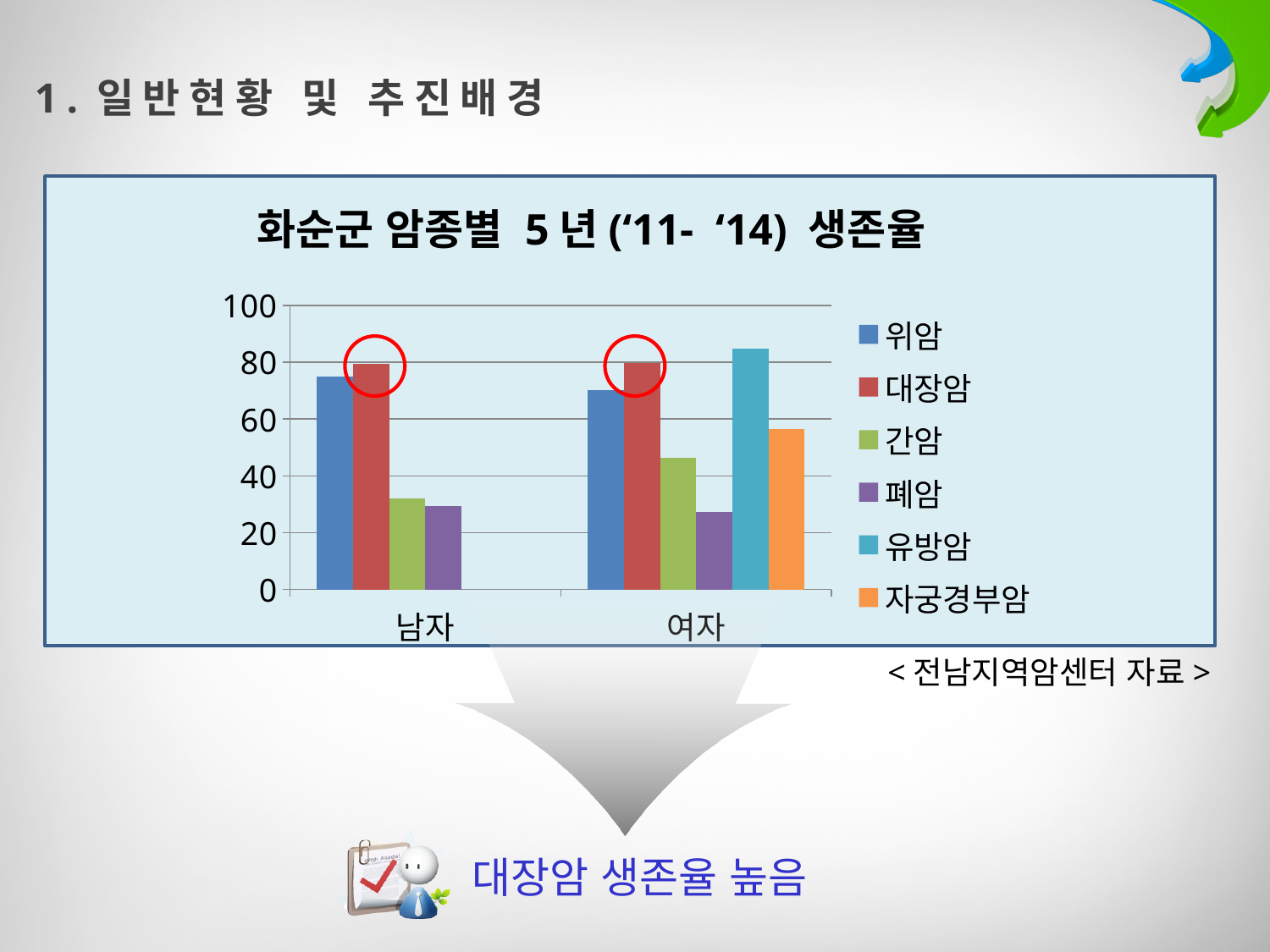
In the 남자 category, which is larger: 위암 or 간암? 위암 What kind of chart is shown on the slide? bar chart Is the value for 폐암 in the 여자 category greater or less than 40? less Is the value for 유방암 in the 여자 category greater or less than 80? greater How many series does the legend list? 6 Which series is highlighted with red circles in both categories? 대장암 Is the value for 위암 in the 남자 category greater or less than 60? greater Which series has the lowest value in the 여자 category? 폐암 How many categories are shown on the x axis? 2 Which series has the highest value in the 여자 category? 유방암 What is the title of the chart? 화순군 암종별 5년 ('11- '14) 생존율